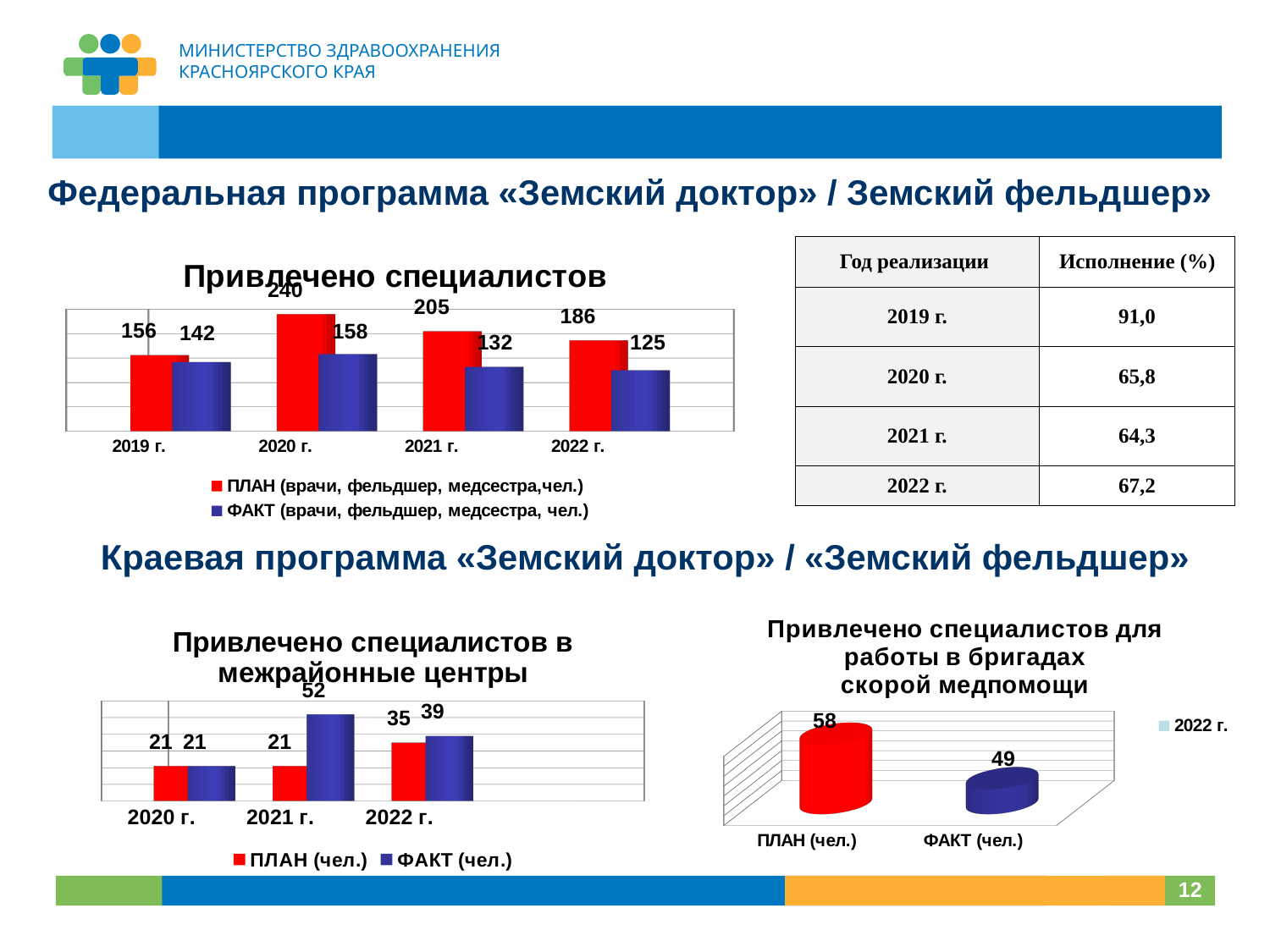
In the chart titled «Привлечено специалистов», does the ФАКТ value rise or fall from 2020 г. to 2022 г.? fall In the chart titled «Привлечено специалистов в межрайонные центры», what is the ФАКТ value for 2021 г.? 52 In the chart titled «Привлечено специалистов для работы в бригадах скорой медпомощи», what is the difference between ПЛАН and ФАКТ? 9 In the chart titled «Привлечено специалистов в межрайонные центры», which is larger for 2022 г., ПЛАН or ФАКТ? ФАКТ In the chart titled «Привлечено специалистов», what is the difference between the ПЛАН and ФАКТ values for 2021 г.? 73 In the chart titled «Привлечено специалистов для работы в бригадах скорой медпомощи», what is the ПЛАН value? 58 In the chart titled «Привлечено специалистов», what is the ФАКТ value for 2022 г.? 125 In the chart titled «Привлечено специалистов», how many years are shown on the x axis? 4 In the chart titled «Привлечено специалистов», which year has the highest ПЛАН value? 2020 г. In the chart titled «Привлечено специалистов в межрайонные центры», how many series does the legend list? 2 In the chart titled «Привлечено специалистов», which year has the lowest ФАКТ value? 2022 г. In the chart titled «Привлечено специалистов», what is the ПЛАН value for 2020 г.? 240